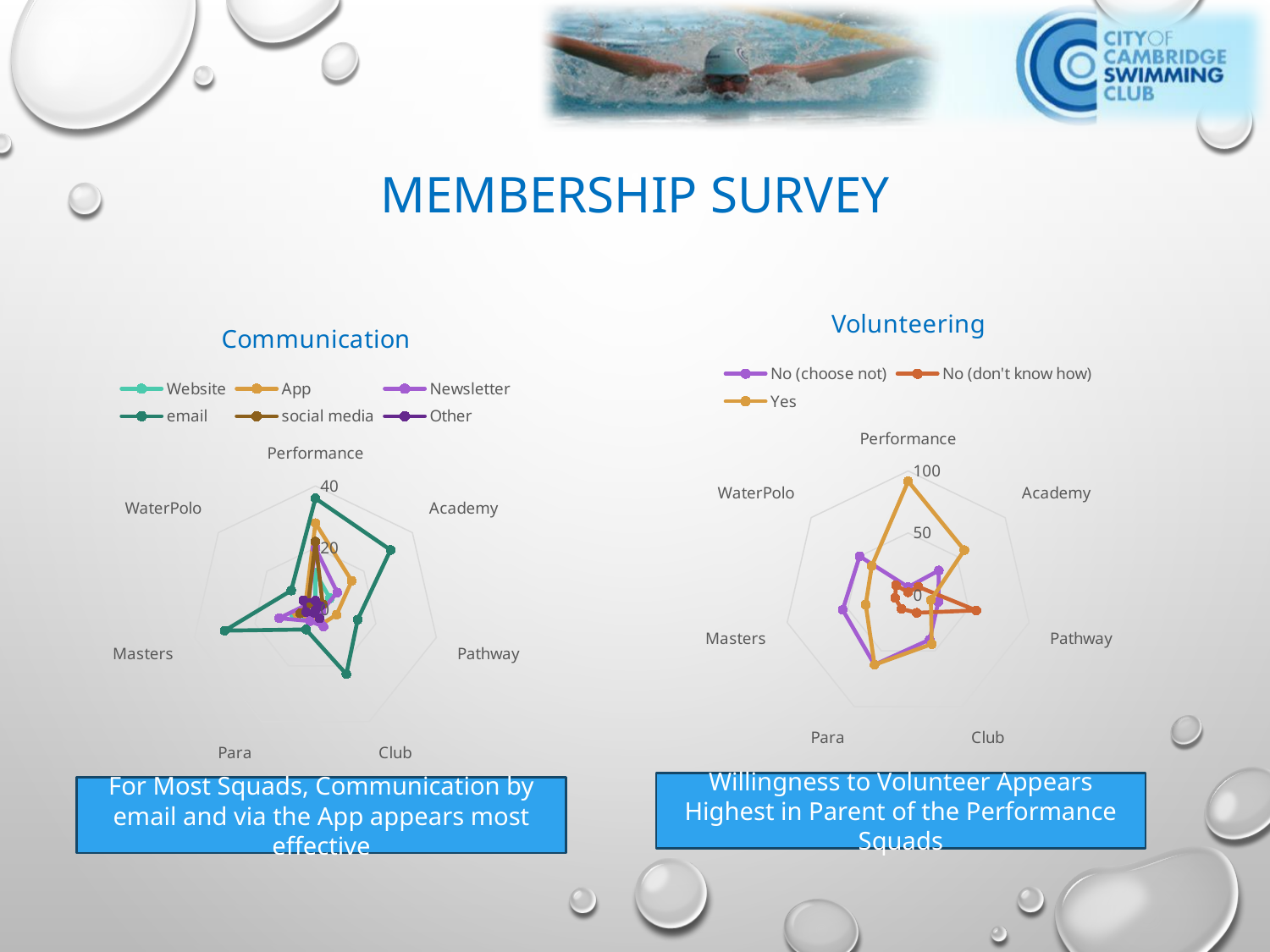
How many series does the legend of the Volunteering chart list? 3 In the Communication chart, is the value for email at Club greater or less than 20? greater How many series does the legend of the Communication chart list? 6 What kind of chart is the Volunteering chart? radar chart In the Volunteering chart, is the value for Yes at Performance greater or less than 50? greater In the Volunteering chart, which series has the highest value at Performance? Yes In the Volunteering chart, is the value for Yes at Academy greater or less than 50? greater How many categories (squads) are plotted on the Volunteering chart? 7 How many categories (squads) are plotted on the Communication chart? 7 In the Volunteering chart, which category has the highest value for the Yes series? Performance What kind of chart is the Communication chart? radar chart